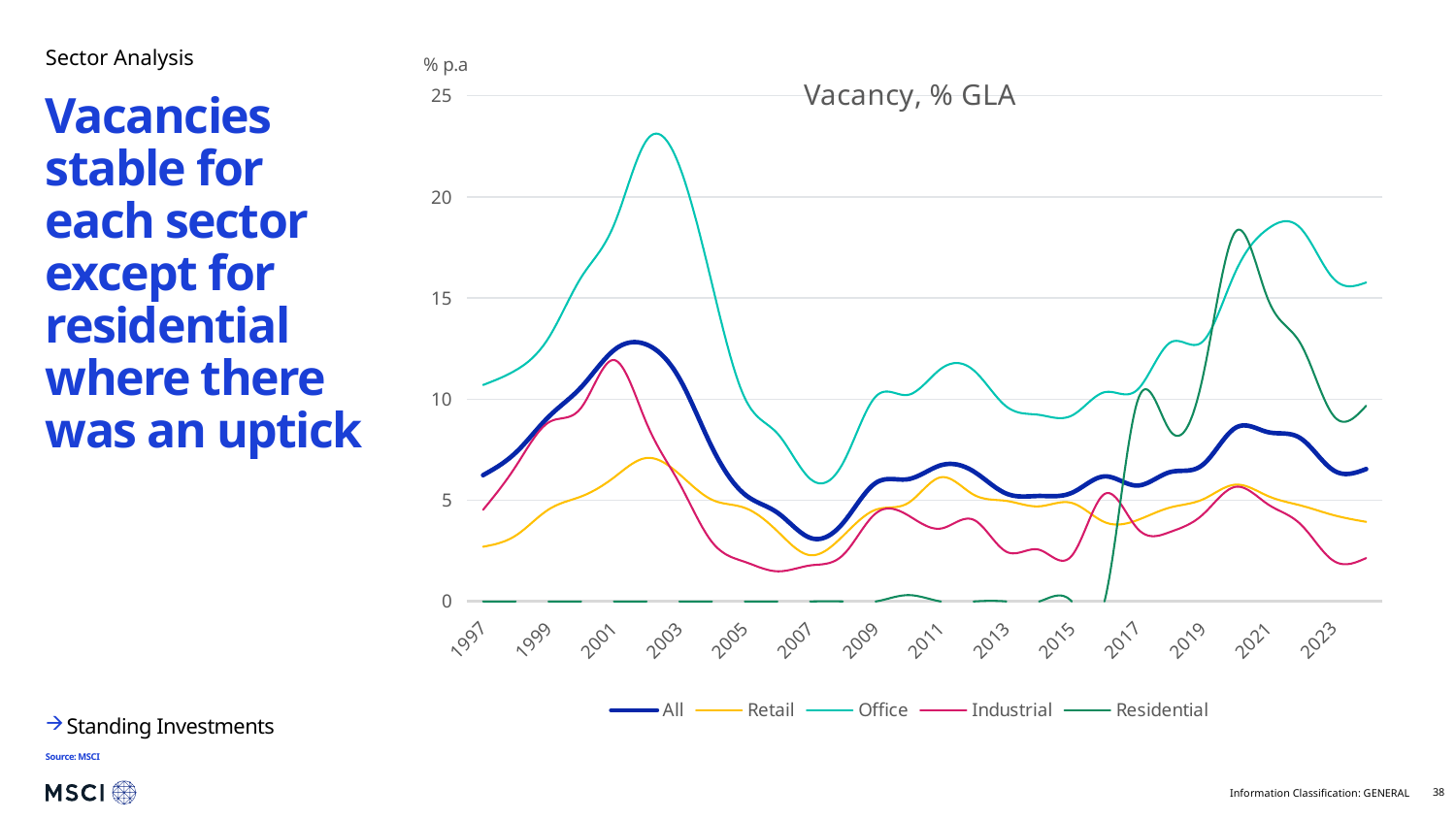
How many series does the legend of the chart list? 5 What is the title of the chart? Vacancy, % GLA Is the peak value of the Office series around 2002 greater or less than 20? greater How many year labels are shown on the x axis of the chart? 14 What kind of chart is shown on the slide? line chart Does the Residential series rise or fall between 2017 and 2020? rise Around 2009, which is larger: the Office value or the Retail value? Office Is the peak value of the Residential series around 2020 greater or less than 15? greater Which series has the highest vacancy rate around 2002? Office Is the value for Retail in 1997 greater or less than 5? less Which series are listed in the chart's legend? All, Retail, Office, Industrial, Residential